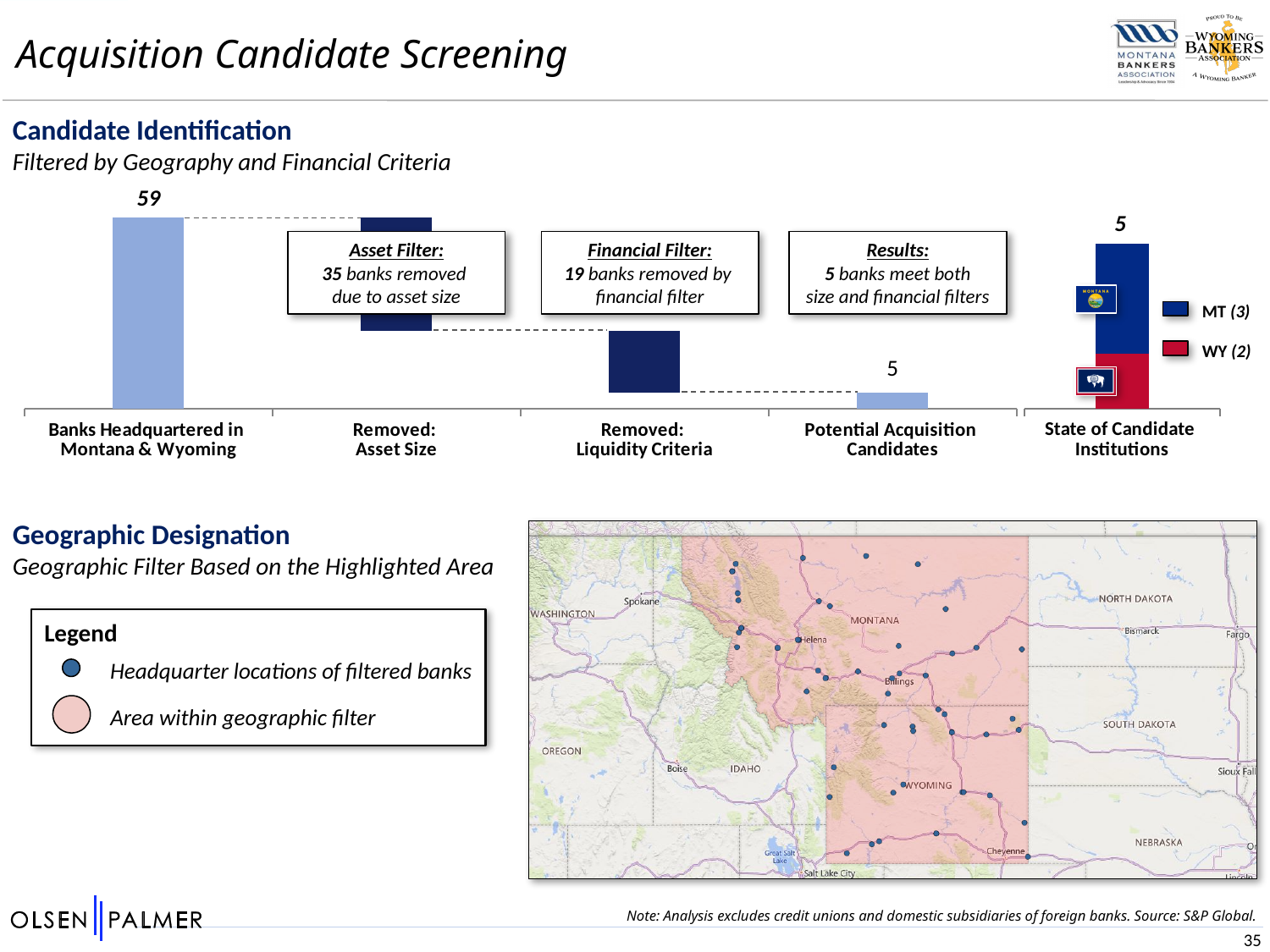
In the Candidate Identification chart, how many banks were removed due to asset size? 35 How many categories are shown along the x axis of the Candidate Identification chart? 5 In the Candidate Identification chart, which category has the highest bar? Banks Headquartered in Montana & Wyoming In the Candidate Identification chart, how many candidate institutions are in MT according to the legend? 3 In the Candidate Identification chart, what is the difference between Banks Headquartered in Montana & Wyoming and Potential Acquisition Candidates? 54 In the Candidate Identification chart, which state has more candidate institutions, MT or WY? MT What kind of chart is the Candidate Identification chart? Bar chart In the Candidate Identification chart, how many banks were removed by the financial filter? 19 In the Candidate Identification chart, what is the value for Banks Headquartered in Montana & Wyoming? 59 In the Candidate Identification chart, how many candidate institutions are in WY according to the legend? 2 In the Candidate Identification chart, what is the value for Potential Acquisition Candidates? 5 In the Candidate Identification chart, what is the total of the stacked State of Candidate Institutions bar? 5